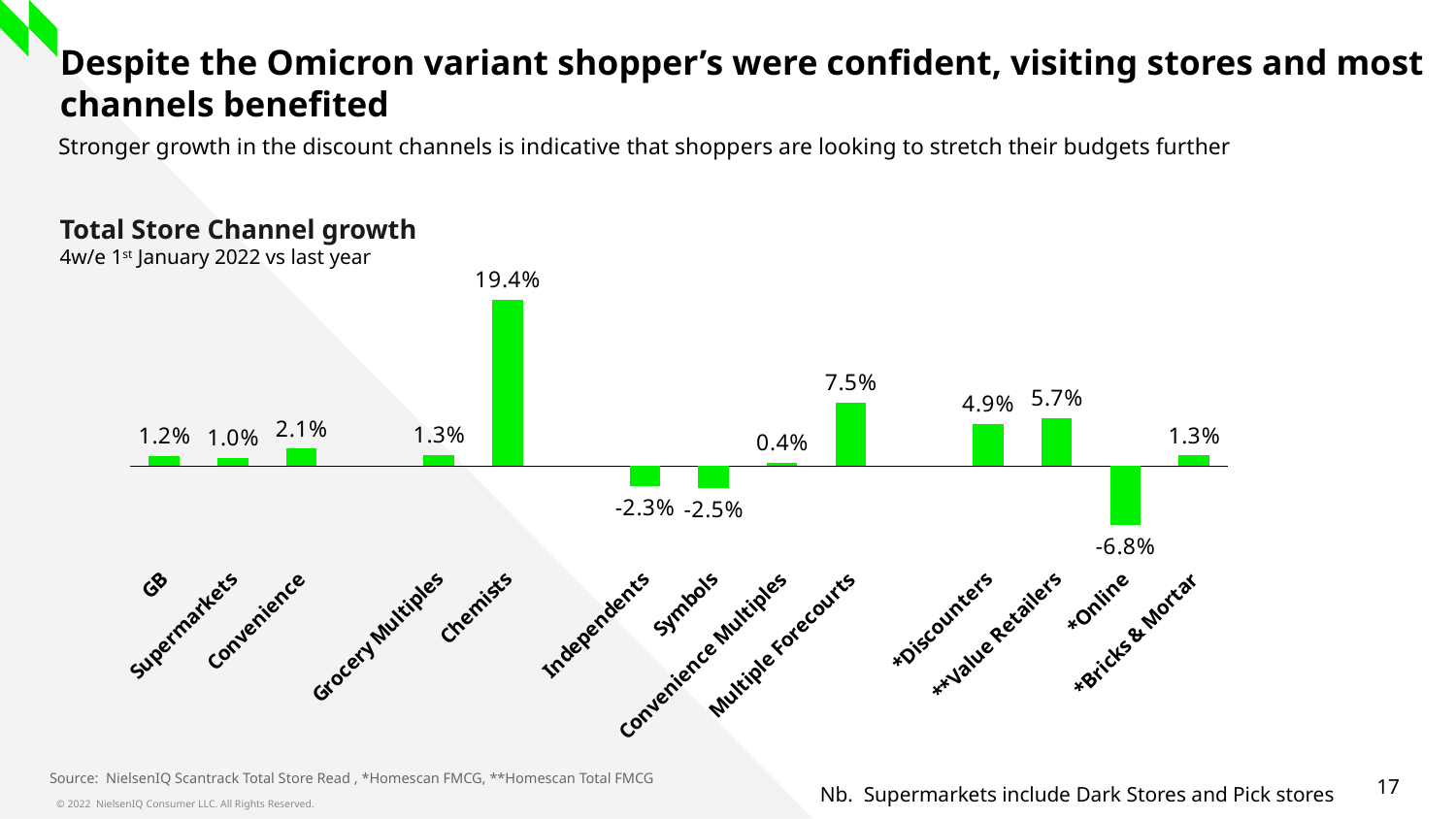
What is the growth value for Chemists? 19.4% What is the title of the chart? Total Store Channel growth What kind of chart is shown on the slide? Bar chart Which channel has the highest growth? Chemists What is the difference between the growth for **Value Retailers and *Discounters? 0.8% What is the growth value for *Online? -6.8% What is the growth value for Supermarkets? 1.0% Which has higher growth, Convenience or Grocery Multiples? Convenience What is the difference between the growth for Chemists and Multiple Forecourts? 11.9% What is the growth value for Multiple Forecourts? 7.5% Which channel has the lowest growth? *Online How many channels are shown in the chart? 13